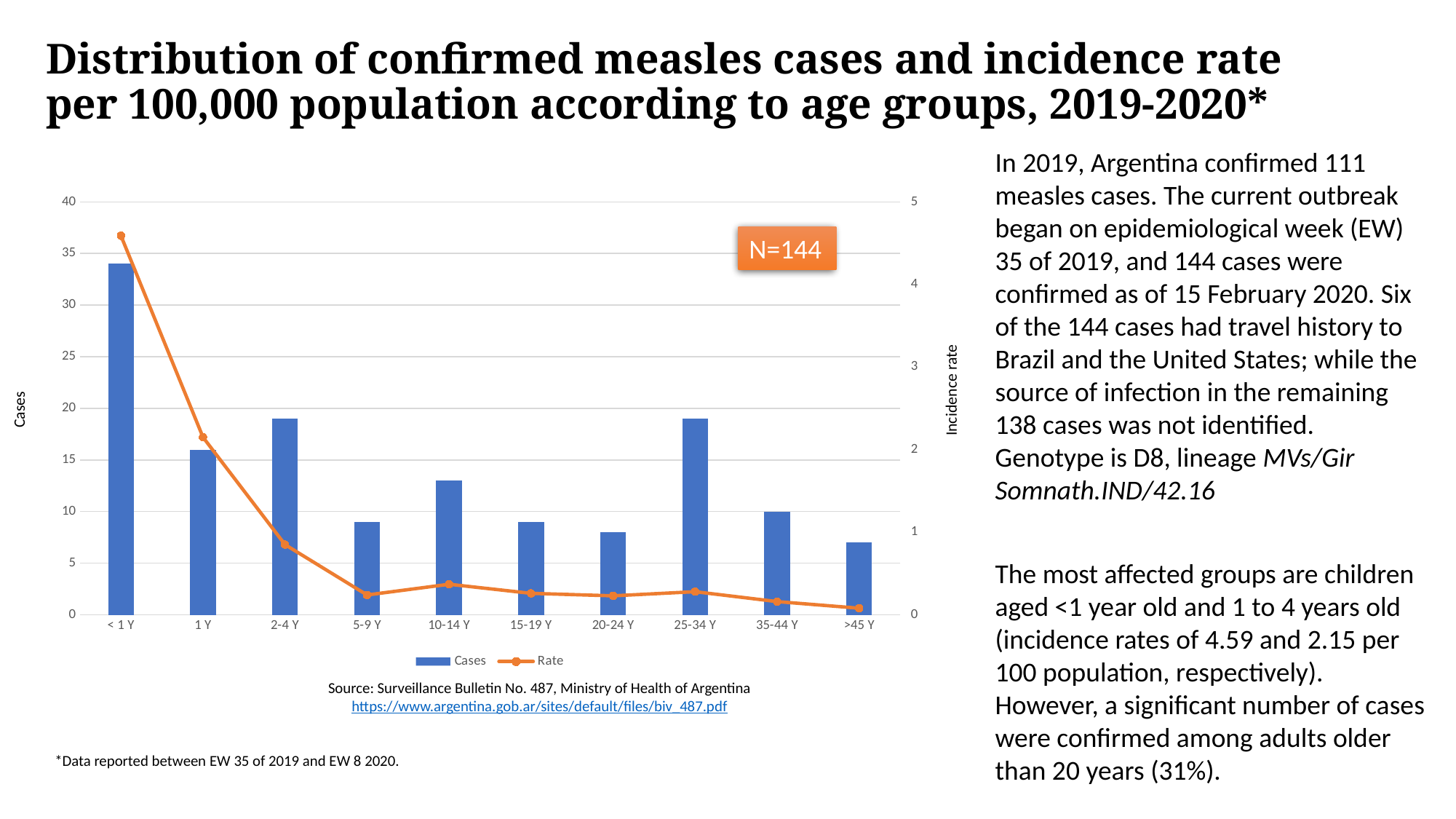
Which age group has the highest number of cases? < 1 Y How many series does the chart legend list? 2 Is the number of cases for 10-14 Y greater or less than 10? greater Is the incidence rate for < 1 Y greater or less than 4? greater What kind of chart is shown on the slide? A combined bar and line chart Which age group has the lowest incidence rate? >45 Y What total N is shown in the orange box on the chart? N=144 Which has more cases, 25-34 Y or 35-44 Y? 25-34 Y Does the incidence rate rise or fall from < 1 Y to 5-9 Y? fall Is the incidence rate for 2-4 Y greater or less than 1? less How many age groups are shown on the x axis of the chart? 10